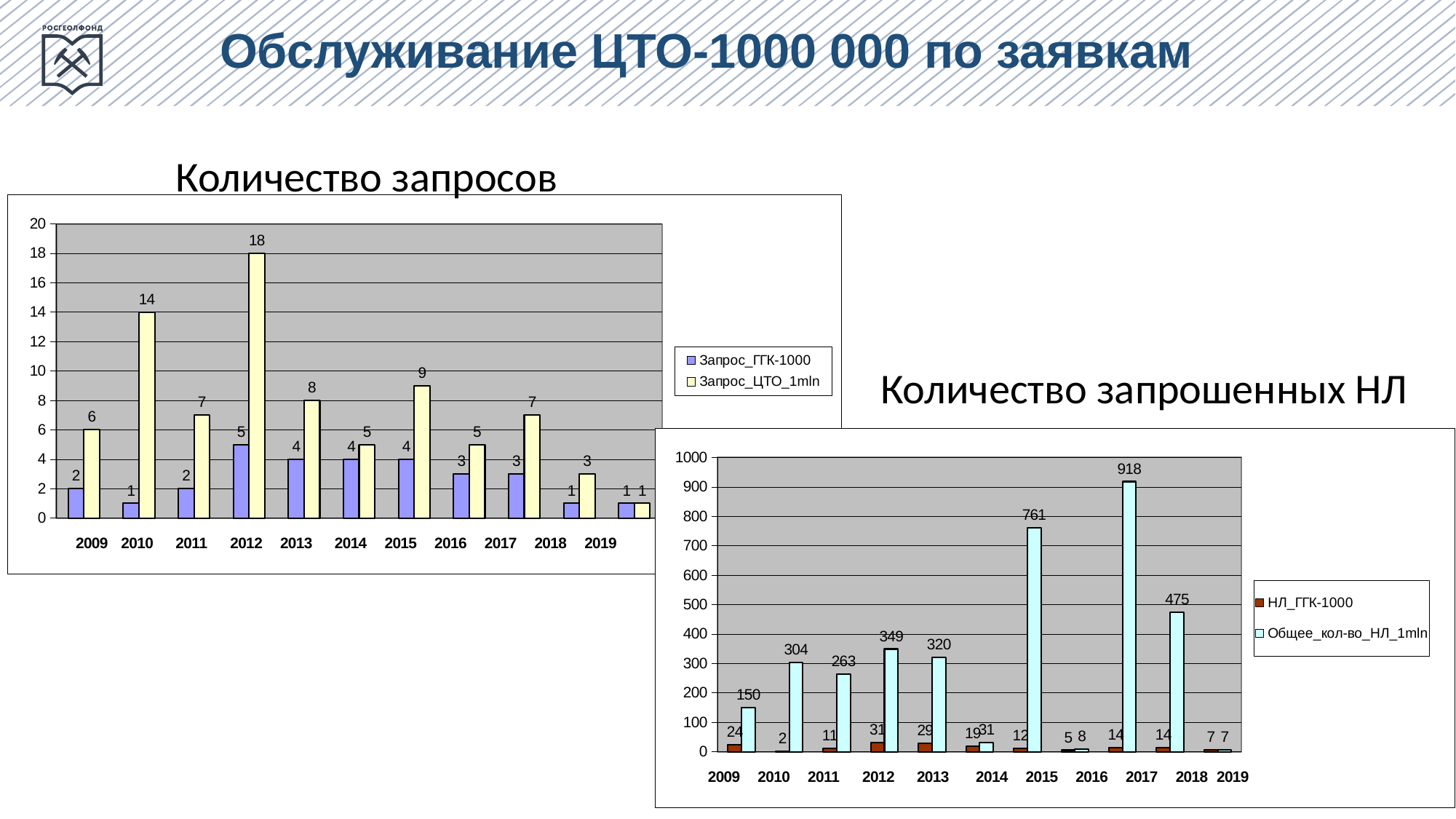
In the chart 'Количество запросов', how many years are shown on the x axis? 11 In the chart 'Количество запрошенных НЛ', what is the difference between Общее_кол-во_НЛ_1mln in 2012 and 2013? 29 In the chart 'Количество запрошенных НЛ', which is larger: Общее_кол-во_НЛ_1mln in 2015 or in 2018? 2015 What type of chart is 'Количество запрошенных НЛ'? Bar chart In the chart 'Количество запросов', how many series does the legend list? 2 In the chart 'Количество запрошенных НЛ', what is the value of Общее_кол-во_НЛ_1mln for 2017? 918 In the chart 'Количество запросов', what is the value of Запрос_ГГК-1000 for 2013? 4 In the chart 'Количество запрошенных НЛ', which year has the lowest value for Общее_кол-во_НЛ_1mln? 2019 In the chart 'Количество запросов', which year has the highest value for Запрос_ЦТО_1mln? 2012 In the chart 'Количество запрошенных НЛ', what is the value of НЛ_ГГК-1000 for 2009? 24 In the chart 'Количество запросов', what is the difference between Запрос_ЦТО_1mln and Запрос_ГГК-1000 in 2010? 13 In the chart 'Количество запросов', what is the value of Запрос_ЦТО_1mln for 2012? 18